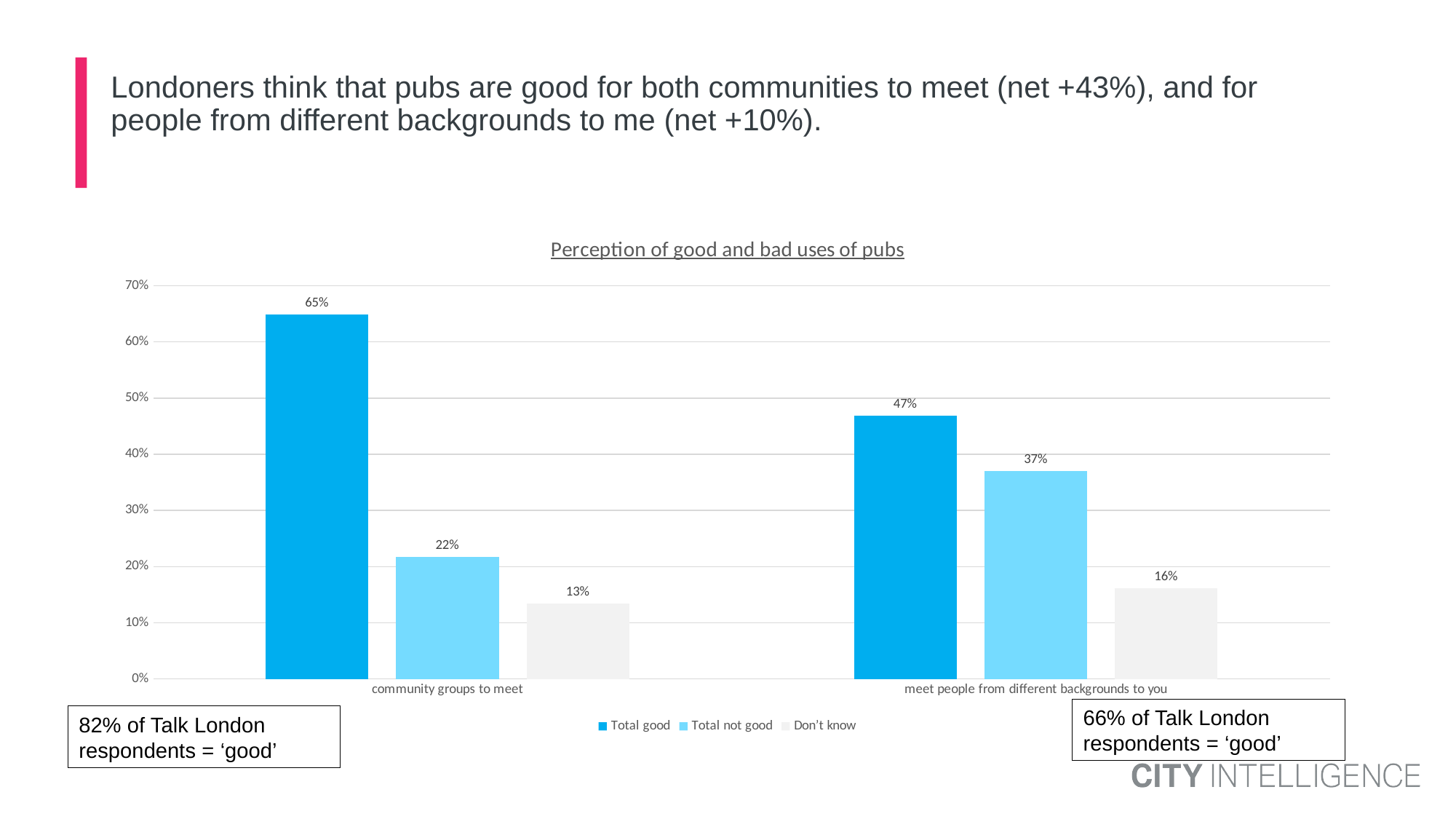
What is the 'Total good' value for 'community groups to meet'? 65% What is the 'Total not good' value for 'meet people from different backgrounds to you'? 37% What is the difference between 'Total good' and 'Total not good' for 'meet people from different backgrounds to you'? 10% Which category has the lowest 'Don't know' value? community groups to meet What kind of chart is shown on the slide? bar chart What is the 'Don't know' value for 'community groups to meet'? 13% Which category has the highest 'Total good' value? community groups to meet Which is larger: 'Total not good' for 'community groups to meet' or 'Total not good' for 'meet people from different backgrounds to you'? meet people from different backgrounds to you What is the difference between 'Total good' and 'Total not good' for 'community groups to meet'? 43% How many series does the legend list? 3 What is the title of the chart? Perception of good and bad uses of pubs What is the 'Total good' value for 'meet people from different backgrounds to you'? 47%